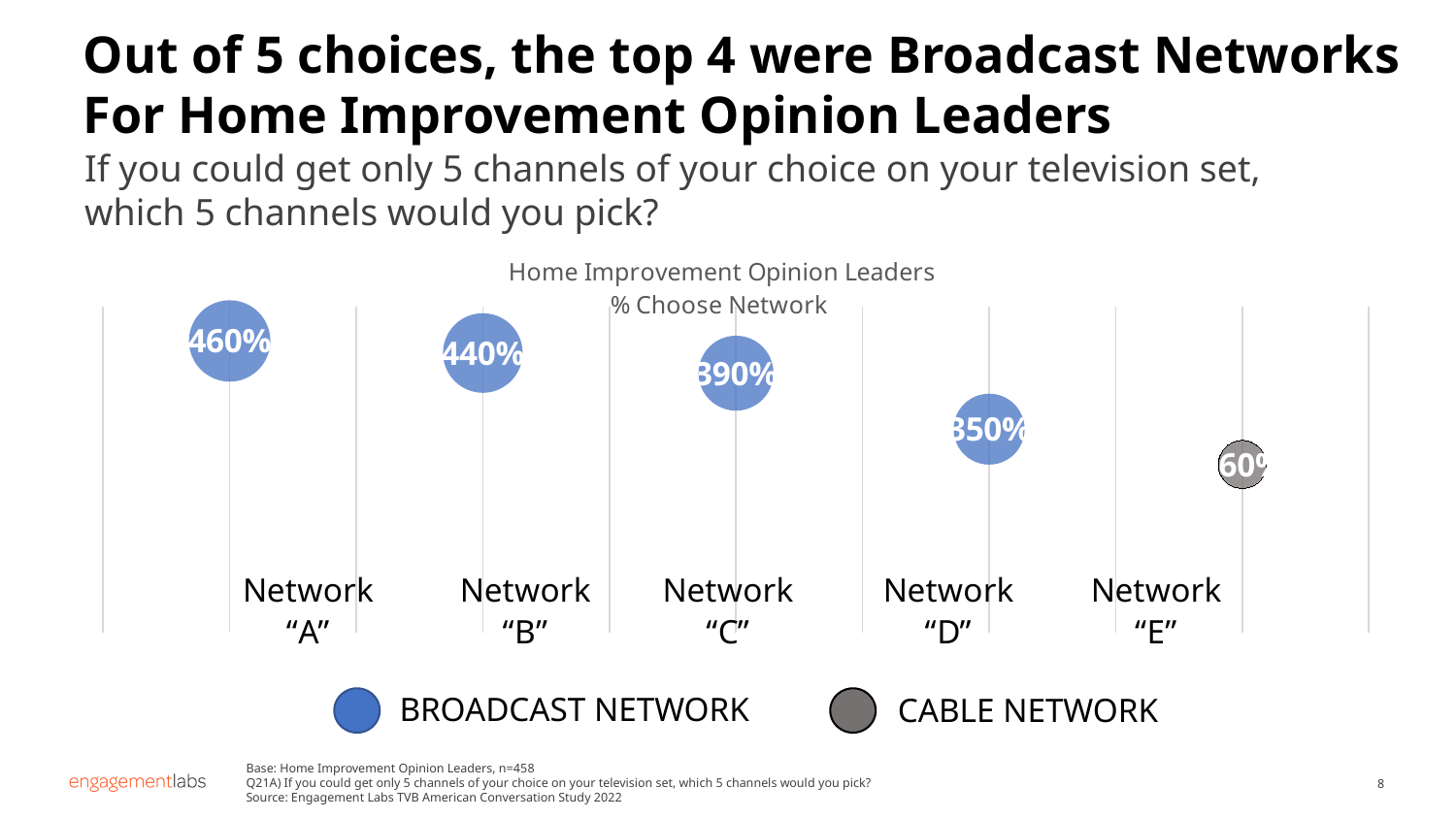
How many entries does the legend list? 2 Which network has the highest value? Network "A" How many networks are plotted on the chart? 5 Which network is shown as a Cable Network in the chart? Network "E" Which network has the lowest value? Network "E" Which has a larger value, Network "B" or Network "D"? Network "B" Do the values rise or fall from Network "A" to Network "E"? fall